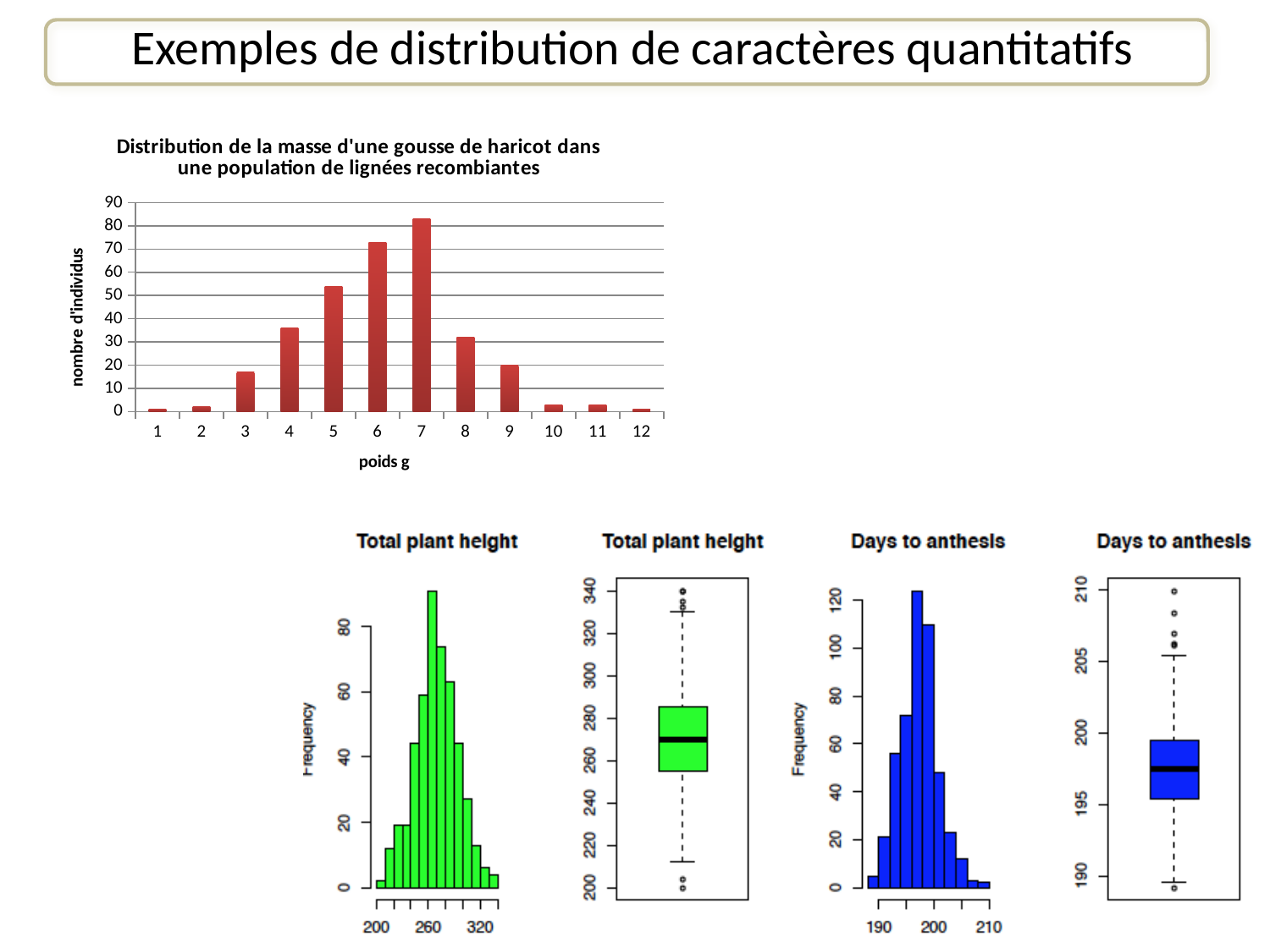
In the chart 'Distribution de la masse d'une gousse de haricot', is the value for poids 4 g greater or less than 40? less What is the y-axis label of the chart 'Distribution de la masse d'une gousse de haricot'? nombre d'individus In the chart 'Distribution de la masse d'une gousse de haricot dans une population de lignées recombiantes', which poids g category has the highest number of individuals? 7 What kind of chart is 'Distribution de la masse d'une gousse de haricot dans une population de lignées recombiantes'? bar chart In the chart 'Distribution de la masse d'une gousse de haricot', do the values rise or fall from poids 7 g to poids 12 g? fall In the chart 'Distribution de la masse d'une gousse de haricot', is the value for poids 5 g greater or less than 50? greater What kind of chart is the second 'Total plant height' plot (the green one on the bottom row, second from left)? box plot In the chart 'Distribution de la masse d'une gousse de haricot', is the value for poids 7 g greater or less than 80? greater In the chart 'Distribution de la masse d'une gousse de haricot', which has more individuals, poids 3 g or poids 4 g? 4 In the chart 'Distribution de la masse d'une gousse de haricot', which has more individuals, poids 8 g or poids 9 g? 8 How many poids g categories are shown on the x axis of the chart 'Distribution de la masse d'une gousse de haricot'? 12